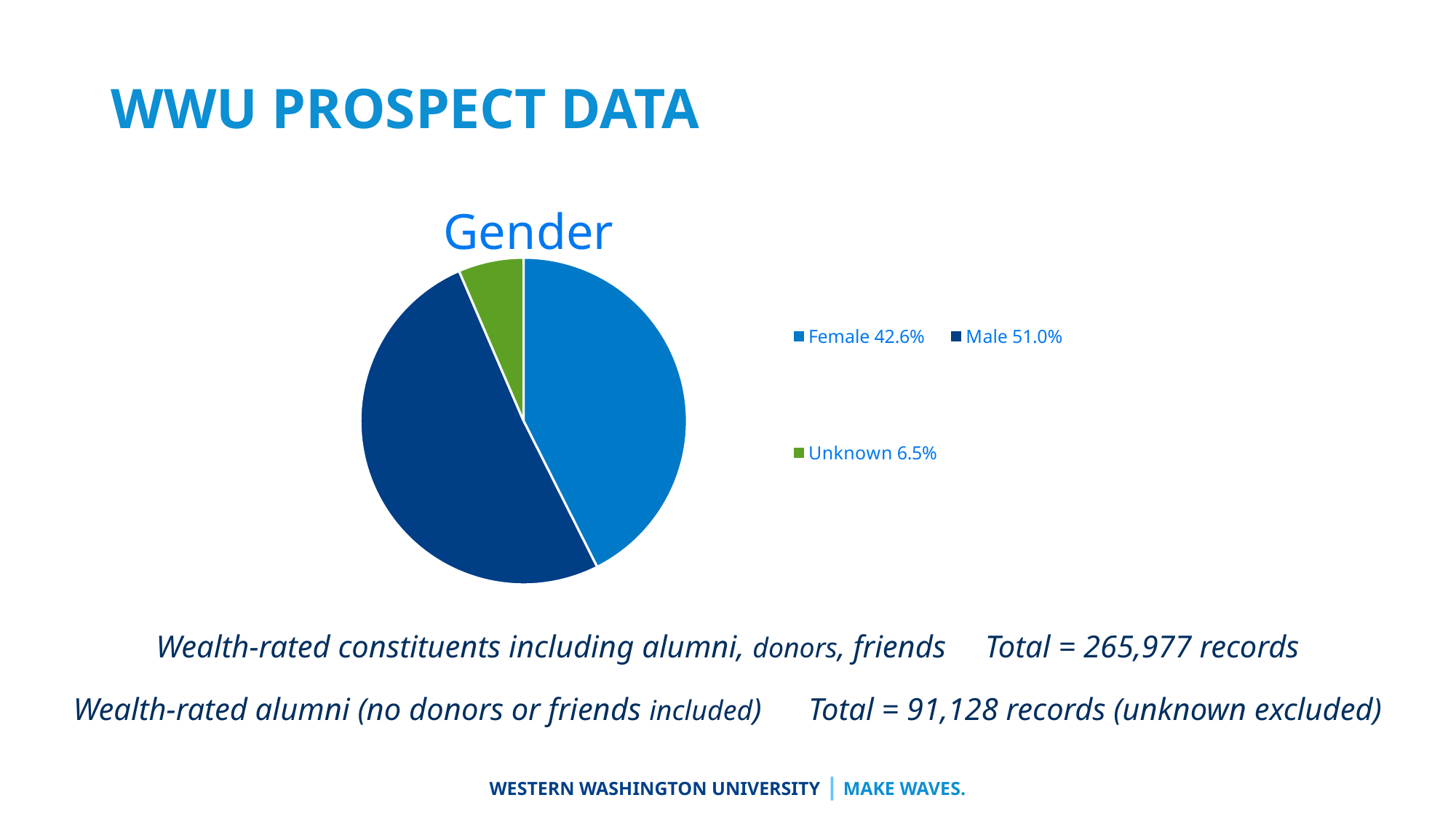
What share of the pie is Female? 42.6% Which category has the smallest slice of the pie? Unknown What colour is the Unknown slice? green Is the Male share greater or less than 50%? greater What share of the pie is Unknown? 6.5% Which category has the largest slice of the pie? Male What share of the pie is Male? 51.0% What is the difference in percentage points between the Male and Female shares? 8.4 What is the title of the chart? Gender What type of chart is shown on the slide? pie chart How many categories does the pie chart show? 3 Which is larger, the Female share or the Male share? Male